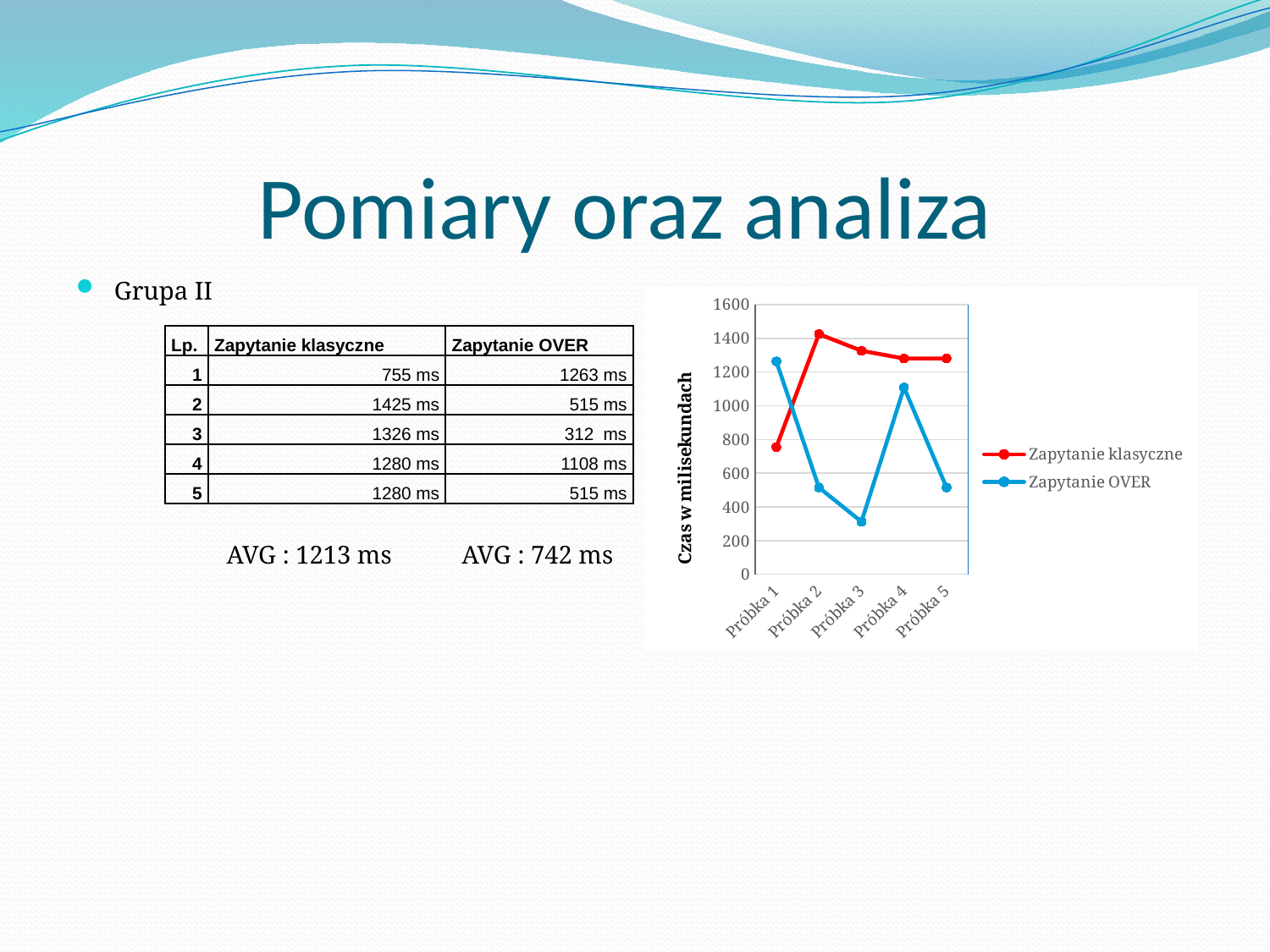
What is the value of Zapytanie OVER for Próbka 3? 312 ms What is the value of Zapytanie klasyczne for Próbka 2? 1425 ms How many samples (Próbka) are plotted along the x axis of the chart? 5 What kind of chart is shown on the slide? line chart Which series is drawn in red on the chart? Zapytanie klasyczne Which series has the larger value for Próbka 1, Zapytanie klasyczne or Zapytanie OVER? Zapytanie OVER What is the label of the chart's vertical axis? Czas w milisekundach How many series does the chart legend list? 2 For which sample is Zapytanie OVER lowest? Próbka 3 For which sample is Zapytanie klasyczne highest? Próbka 2 Is the value of Zapytanie OVER for Próbka 5 greater or less than 600? less What is the difference between Zapytanie klasyczne and Zapytanie OVER for Próbka 4? 172 ms